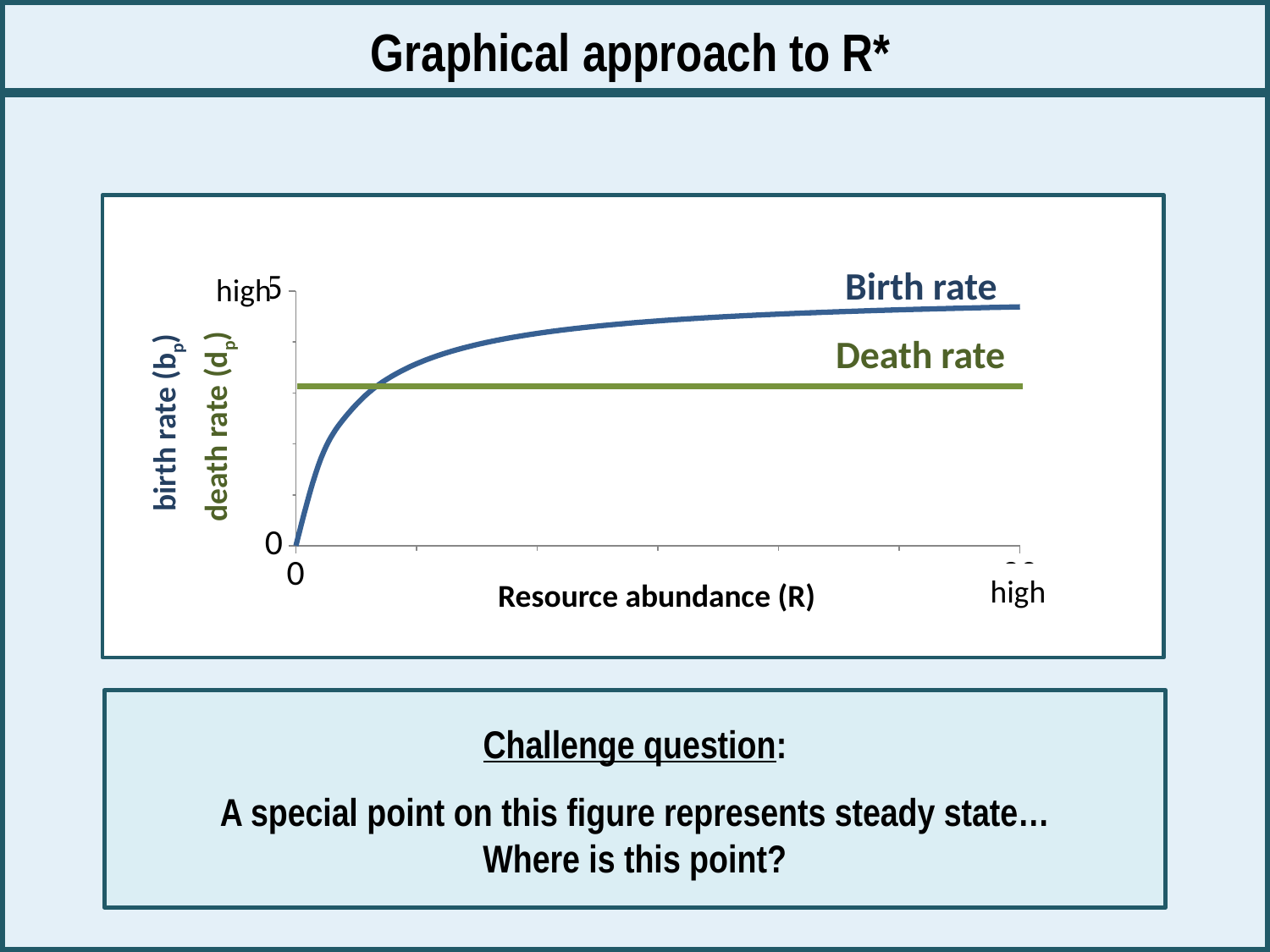
Does the Birth rate curve rise or fall as Resource abundance (R) increases? rise What kind of chart is shown on the slide? line chart Is the value of the Death rate line greater or less than 5? less What is the value of the Birth rate when Resource abundance (R) is 0? 0 At high Resource abundance (R), which is larger, the Birth rate or the Death rate? Birth rate Is the Birth rate at the highest Resource abundance (R) greater or less than 5? less What is the highest tick value shown on the y axis? 5 How many series are plotted on the chart? 2 What is the title of the x axis? Resource abundance (R) What are the names of the two series plotted on the chart? Birth rate and Death rate Does the Death rate line rise, fall, or stay flat as Resource abundance (R) increases? stay flat At Resource abundance (R) equal to 0, which is larger, the Birth rate or the Death rate? Death rate